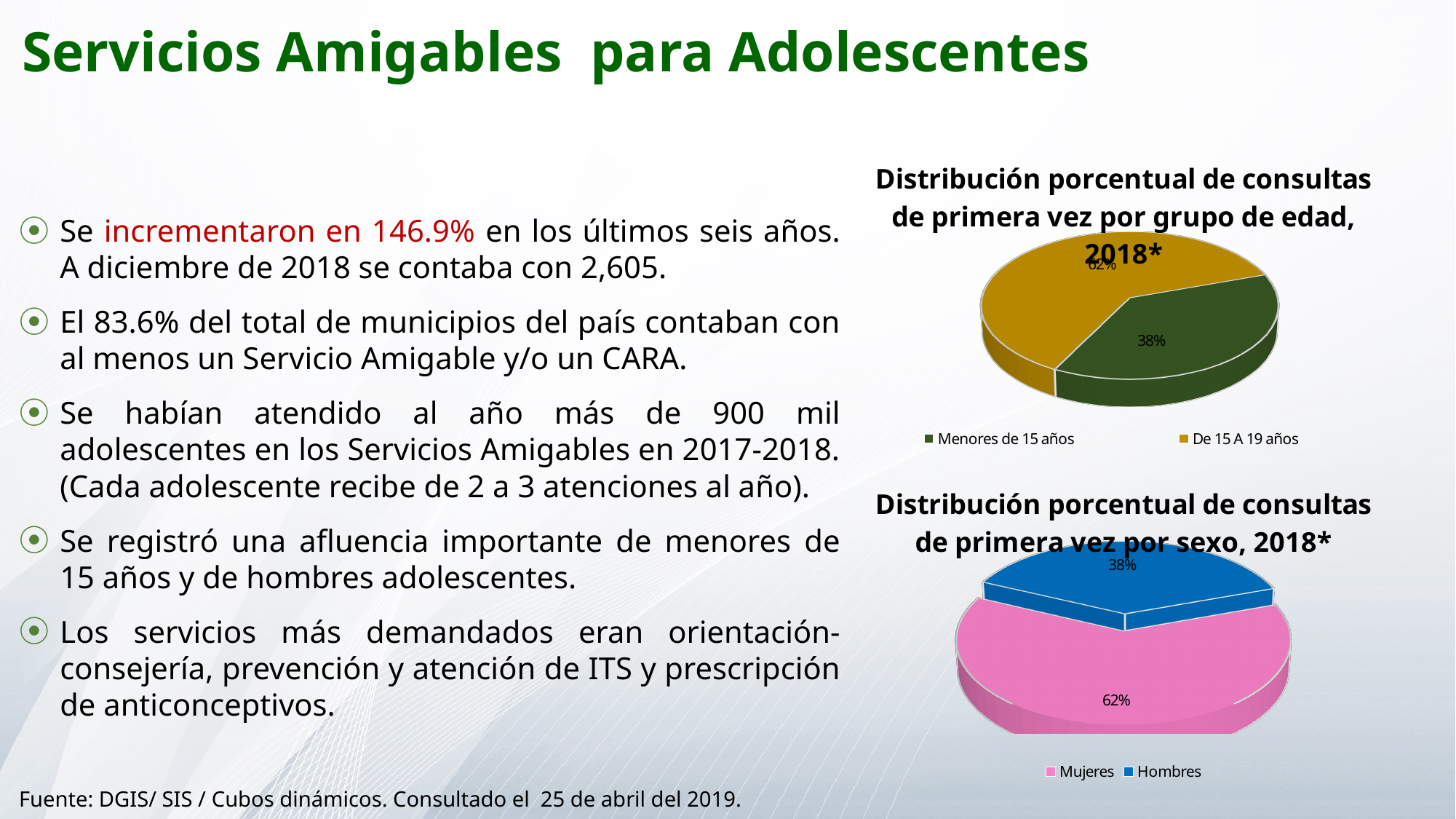
In the chart 'Distribución porcentual de consultas de primera vez por grupo de edad, 2018*', which age group has the largest share? De 15 A 19 años In the chart 'Distribución porcentual de consultas de primera vez por sexo, 2018*', what is the difference in percentage points between Mujeres and Hombres? 24 percentage points How many slices does the chart 'Distribución porcentual de consultas de primera vez por sexo, 2018*' have? 2 What type of chart is 'Distribución porcentual de consultas de primera vez por grupo de edad, 2018*'? Pie chart In the chart 'Distribución porcentual de consultas de primera vez por sexo, 2018*', which group has the larger share, Mujeres or Hombres? Mujeres In the chart 'Distribución porcentual de consultas de primera vez por sexo, 2018*', what share corresponds to 'Hombres'? 38% In the chart 'Distribución porcentual de consultas de primera vez por grupo de edad, 2018*', which age group has the smallest share? Menores de 15 años In the chart 'Distribución porcentual de consultas de primera vez por sexo, 2018*', what colour represents 'Hombres'? Blue In the chart 'Distribución porcentual de consultas de primera vez por grupo de edad, 2018*', what share corresponds to 'De 15 A 19 años'? 62% How many categories does the legend of the chart 'Distribución porcentual de consultas de primera vez por grupo de edad, 2018*' list? 2 In the chart 'Distribución porcentual de consultas de primera vez por grupo de edad, 2018*', what share of first-time consultations corresponds to 'Menores de 15 años'? 38% In the chart 'Distribución porcentual de consultas de primera vez por sexo, 2018*', what share corresponds to 'Mujeres'? 62%